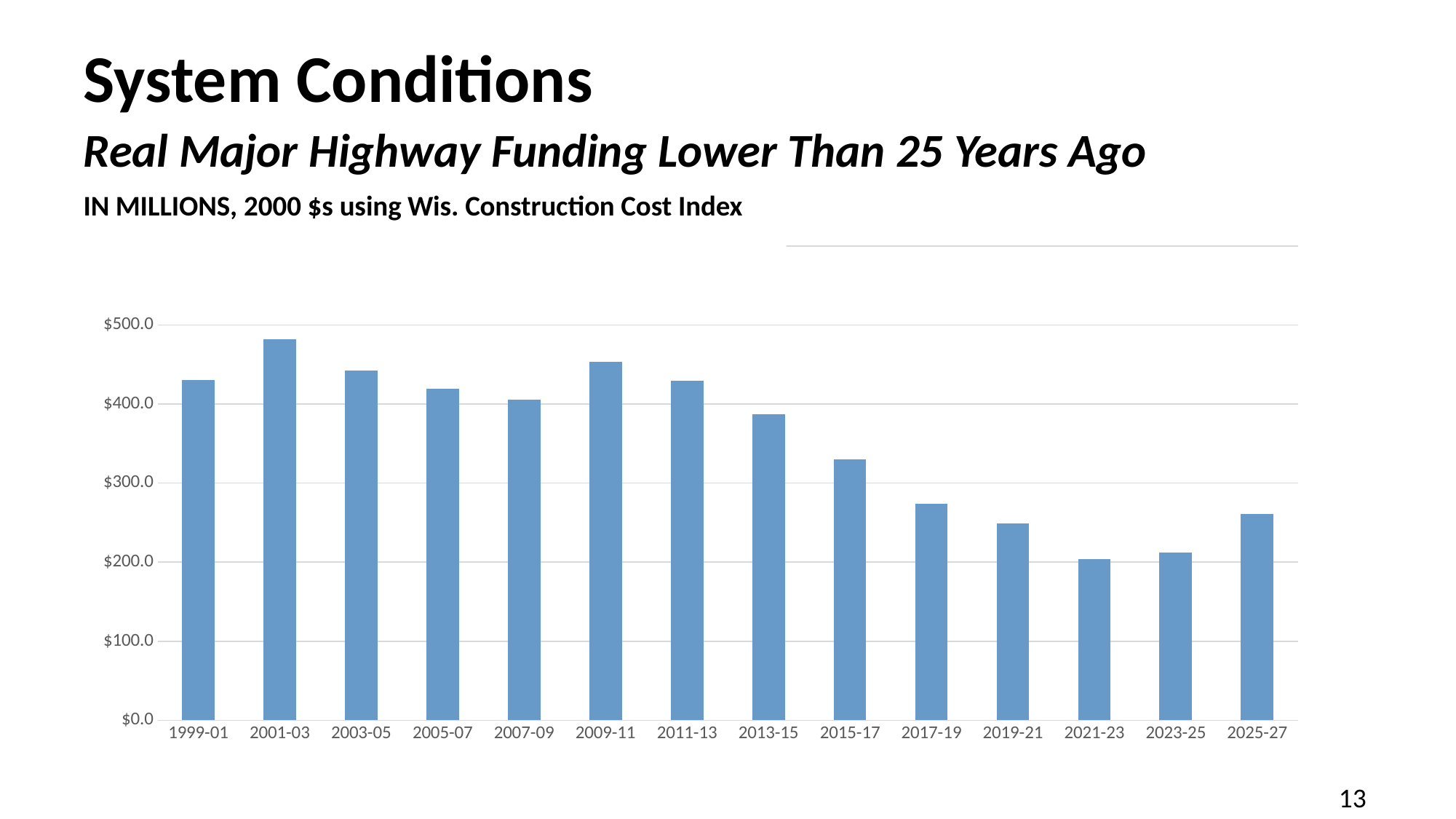
Which is larger, the value for 2009-11 or the value for 2011-13? 2009-11 Is the value for 2015-17 greater or less than $300.0? greater Is the value for 2025-27 greater or less than $300.0? less What kind of chart is shown on the slide? bar chart Is the value for 2001-03 greater or less than $500.0? less Which biennium has the highest real major highway funding? 2001-03 Overall, do the values rise or fall from 1999-01 to 2021-23? fall How many biennia (bars) are shown on the chart? 14 Which is larger, the value for 2015-17 or the value for 2017-19? 2015-17 Which biennium has the lowest real major highway funding? 2021-23